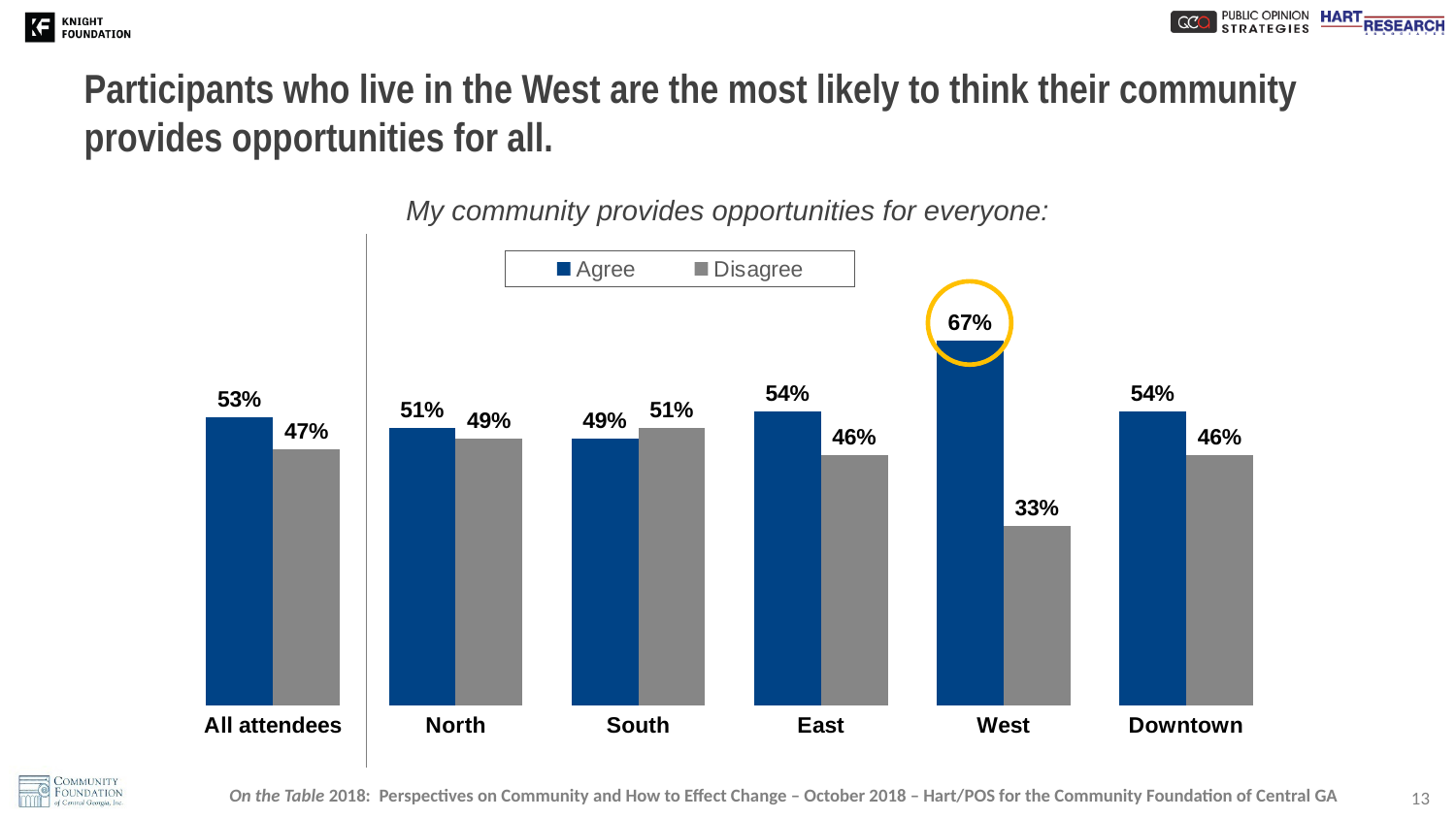
What is the difference between the Agree and Disagree values for West? 34 percentage points How many categories are shown on the x axis? 6 Which category has the highest Agree value? West What kind of chart is shown on the slide? Bar chart What is the Agree value for All attendees? 53% Which series is shown in blue according to the legend? Agree What is the Disagree value for South? 51% What is the difference between the Agree values for West and North? 16 percentage points What percentage of West participants agree that their community provides opportunities for everyone? 67% Which category has the lowest Disagree value? West Which is larger for South, the Agree value or the Disagree value? Disagree How many series does the legend list? 2